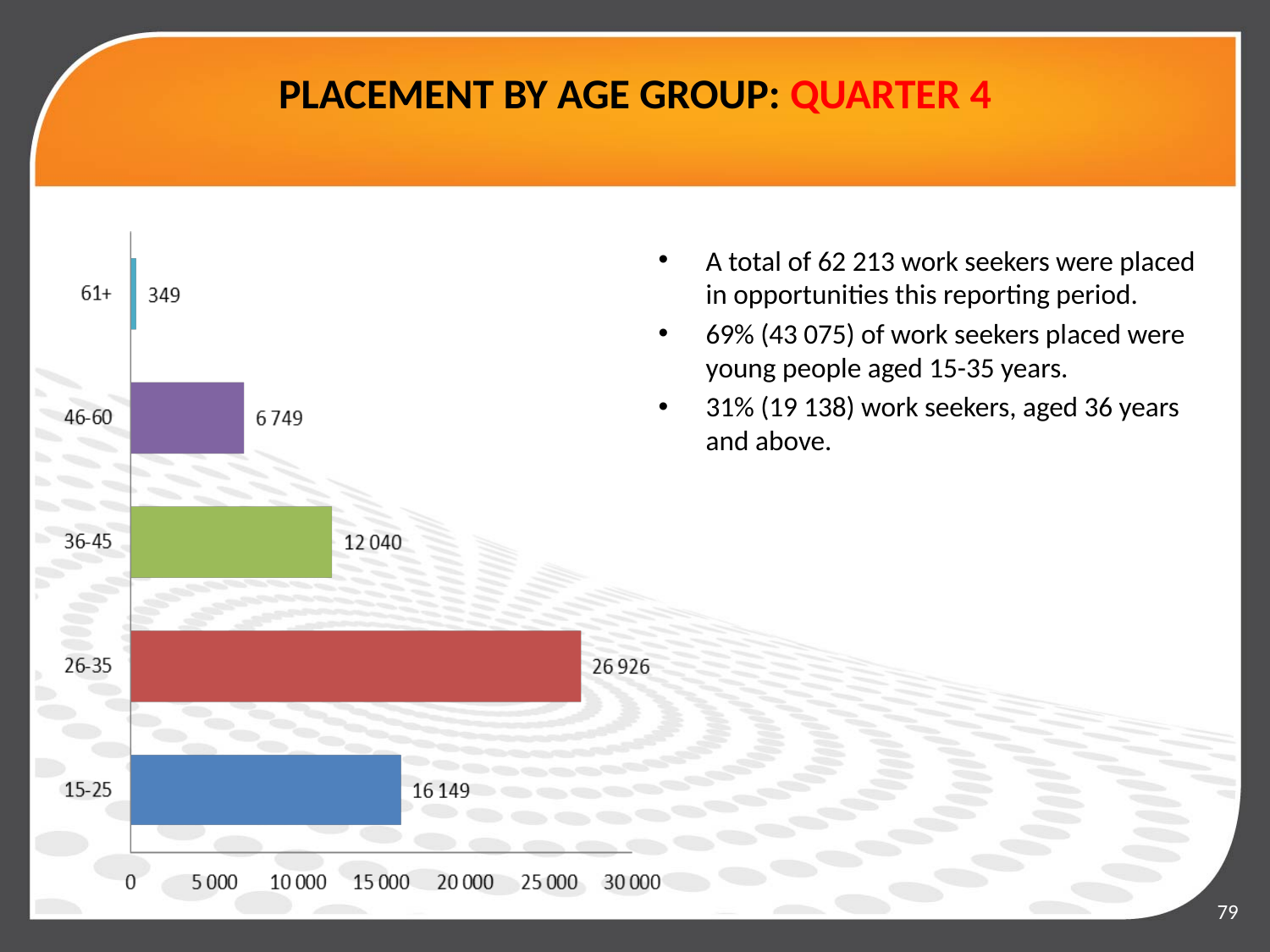
Is the value for 46-60 greater or less than 10 000? less What is the difference between the values for 26-35 and 15-25? 10 777 Which is larger, the value for 36-45 or the value for 46-60? 36-45 Which age group has the lowest placement value? 61+ How many age groups are shown in the chart? 5 What is the value for the 15-25 age group? 16 149 What kind of chart is shown on the slide? bar chart What is the title of the slide? PLACEMENT BY AGE GROUP: QUARTER 4 What is the value for the 61+ age group? 349 What is the value for the 36-45 age group? 12 040 Which age group has the highest placement value? 26-35 What is the value for the 26-35 age group? 26 926